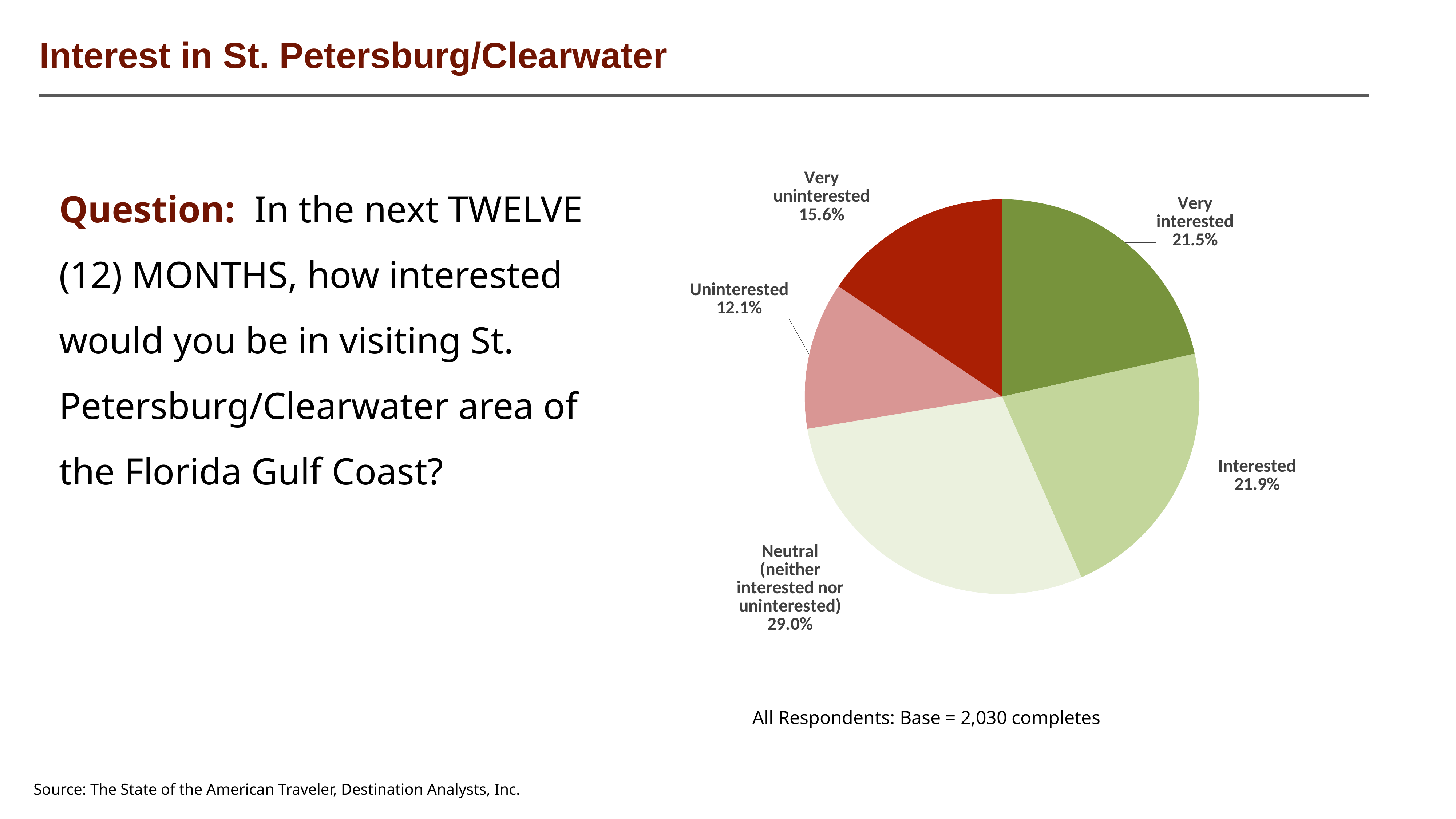
What percentage of respondents are Very interested in visiting St. Petersburg/Clearwater? 21.5% Which response category has the largest share of the pie? Neutral (neither interested nor uninterested) What type of chart is shown on the slide? Pie chart How many slices does the pie chart have? 5 What is the combined percentage of respondents who are Very interested or Interested? 43.4% What is the difference in percentage points between the Neutral slice and the Very uninterested slice? 13.4 What is the difference in percentage points between the Interested slice and the Very interested slice? 0.4 What percentage of respondents are Uninterested? 12.1% What percentage of respondents are Very uninterested? 15.6% Which is larger, the Very uninterested slice or the Uninterested slice? Very uninterested What percentage of respondents are Neutral (neither interested nor uninterested)? 29.0% Which response category has the smallest share of the pie? Uninterested